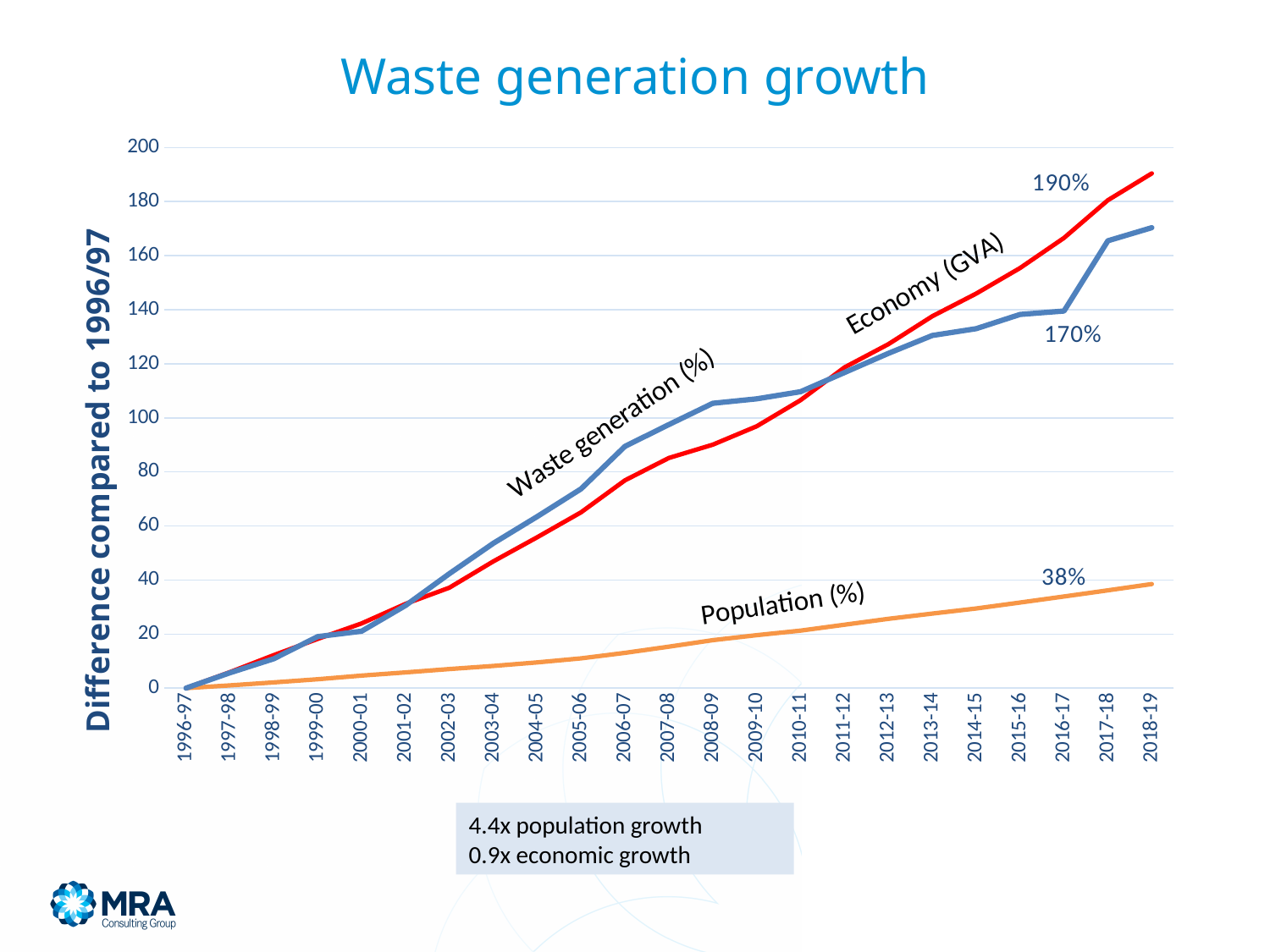
What is the labelled value for Population (%) at the end of the series in 2018-19? 38% What type of chart is shown on the slide? Line chart In 2006-07, is the value for Population (%) greater or less than 20? less In 2008-09, is the value for Economy (GVA) greater or less than 100? less Which series has the highest value in 2018-19? Economy (GVA) Which series has the lowest value in 2018-19? Population (%) How many years are shown on the x axis? 23 In 2008-09, is the value for Waste generation (%) greater or less than 100? greater How many series are plotted on the chart? 3 What is the labelled value for Waste generation (%) at the end of the series in 2018-19? 170% What is the labelled value for Economy (GVA) at the end of the series in 2018-19? 190% What is the difference between the labelled end values of Economy (GVA) and Waste generation (%)? 20%